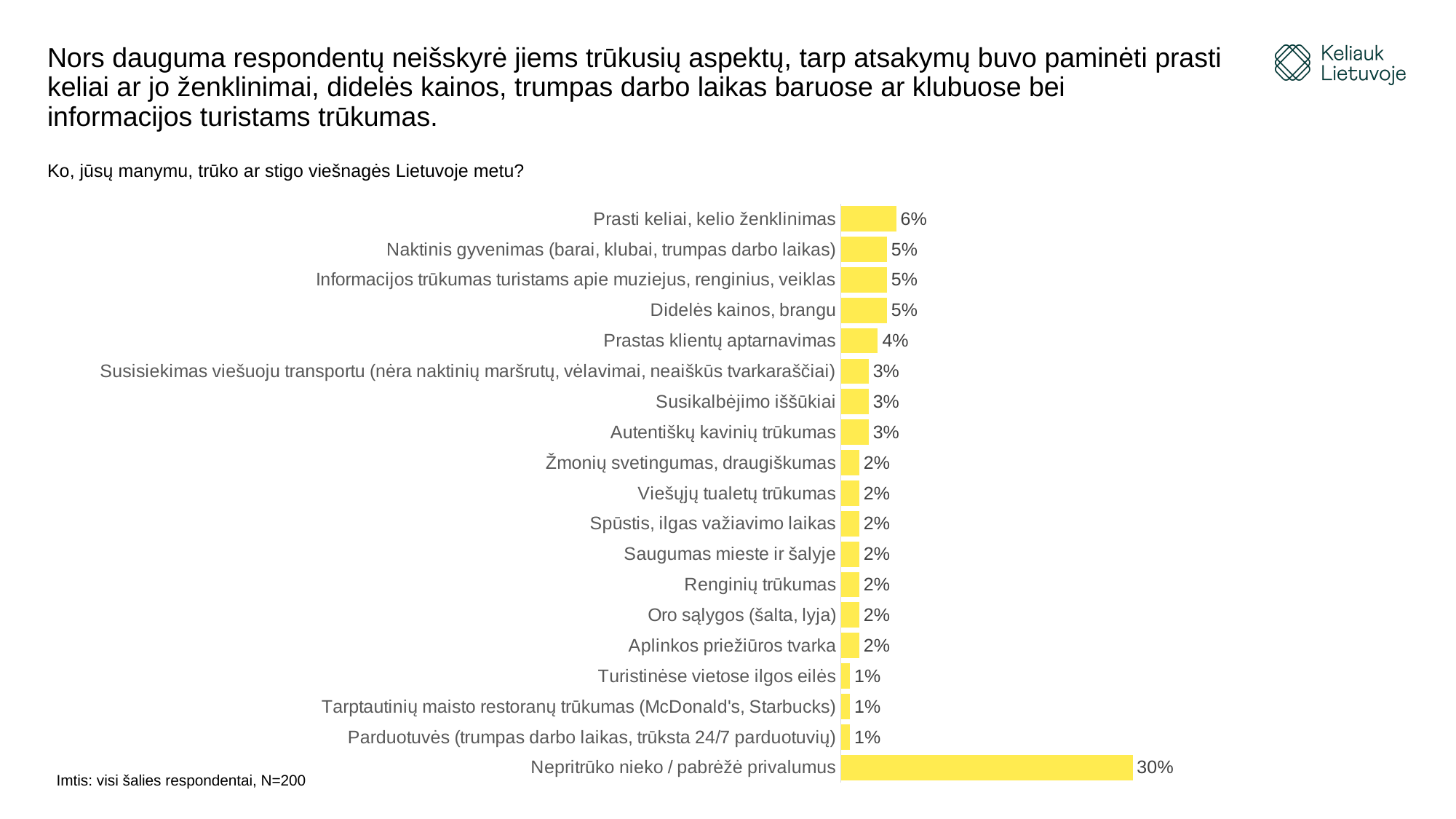
What percentage of respondents mentioned "Prasti keliai, kelio ženklinimas"? 6% What is the difference between the values for "Nepritrūko nieko / pabrėžė privalumus" and "Prasti keliai, kelio ženklinimas"? 24% Which is larger: the value for "Turistinėse vietose ilgos eilės" or the value for "Renginių trūkumas"? Renginių trūkumas What is the value for "Nepritrūko nieko / pabrėžė privalumus"? 30% What type of chart is shown on the slide? Bar chart What colour are the bars in the chart? Yellow Which is larger: the value for "Didelės kainos, brangu" or the value for "Autentiškų kavinių trūkumas"? Didelės kainos, brangu What is the value for "Susikalbėjimo iššūkiai"? 3% What is the value for "Prastas klientų aptarnavimas"? 4% What is the difference between the values for "Prasti keliai, kelio ženklinimas" and "Prastas klientų aptarnavimas"? 2% Which category has the highest value in the chart? Nepritrūko nieko / pabrėžė privalumus How many categories are shown in the chart? 19